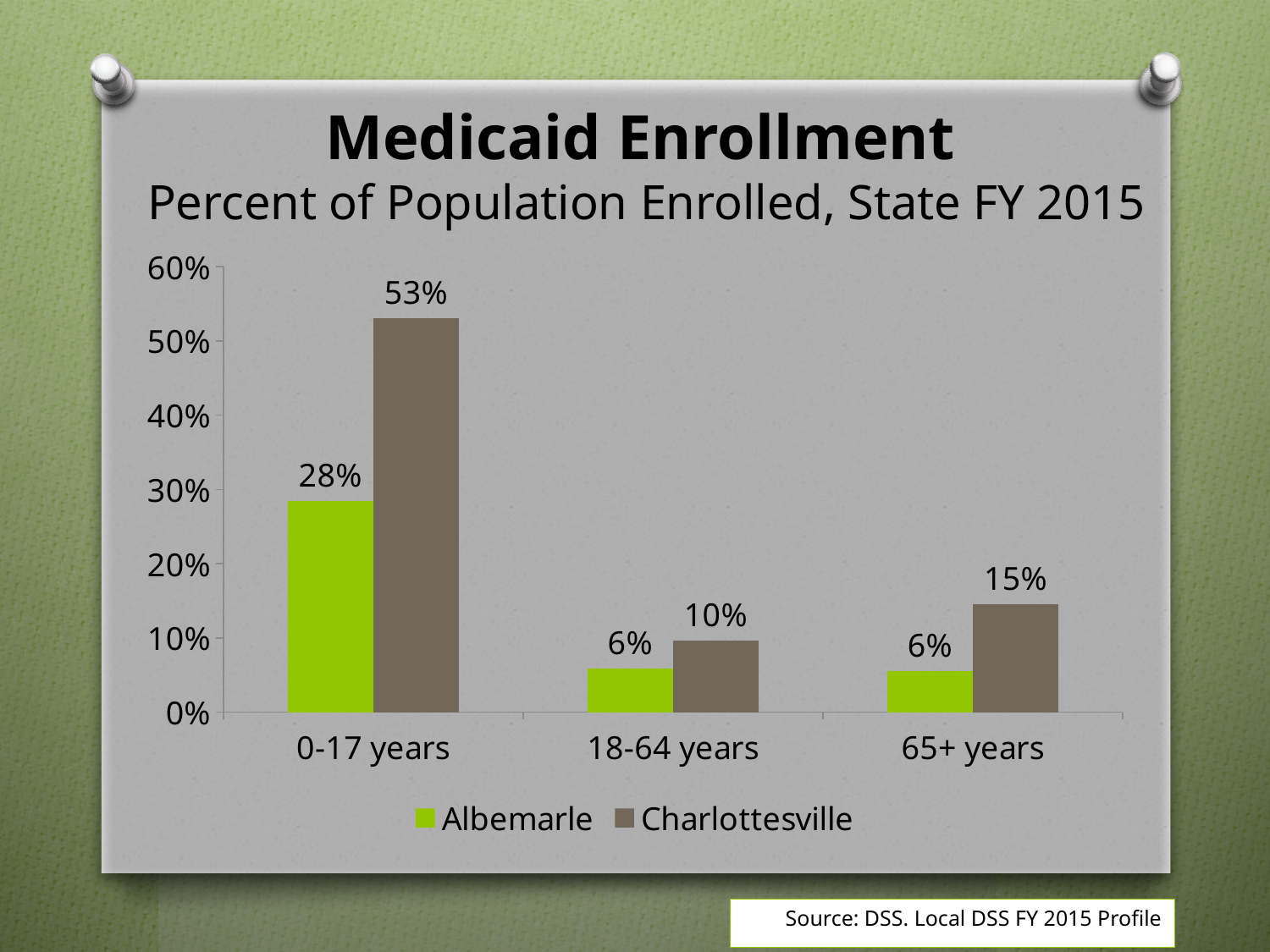
In the 18-64 years group, which has the larger enrollment percentage, Albemarle or Charlottesville? Charlottesville What is the Medicaid enrollment percentage for Charlottesville in the 65+ years group? 15% Which age group has the lowest Medicaid enrollment percentage for Charlottesville? 18-64 years What is the Medicaid enrollment percentage for Albemarle in the 0-17 years group? 28% What is the difference between the Charlottesville and Albemarle enrollment percentages in the 65+ years group? 9% What type of chart is shown on the slide? Bar chart How many age groups are shown on the x axis? 3 What is the difference between the Charlottesville and Albemarle enrollment percentages in the 0-17 years group? 25% Which age group has the highest Medicaid enrollment percentage for Charlottesville? 0-17 years What is the Medicaid enrollment percentage for Albemarle in the 18-64 years group? 6% What is the Medicaid enrollment percentage for Charlottesville in the 0-17 years group? 53% How many series does the legend list? 2